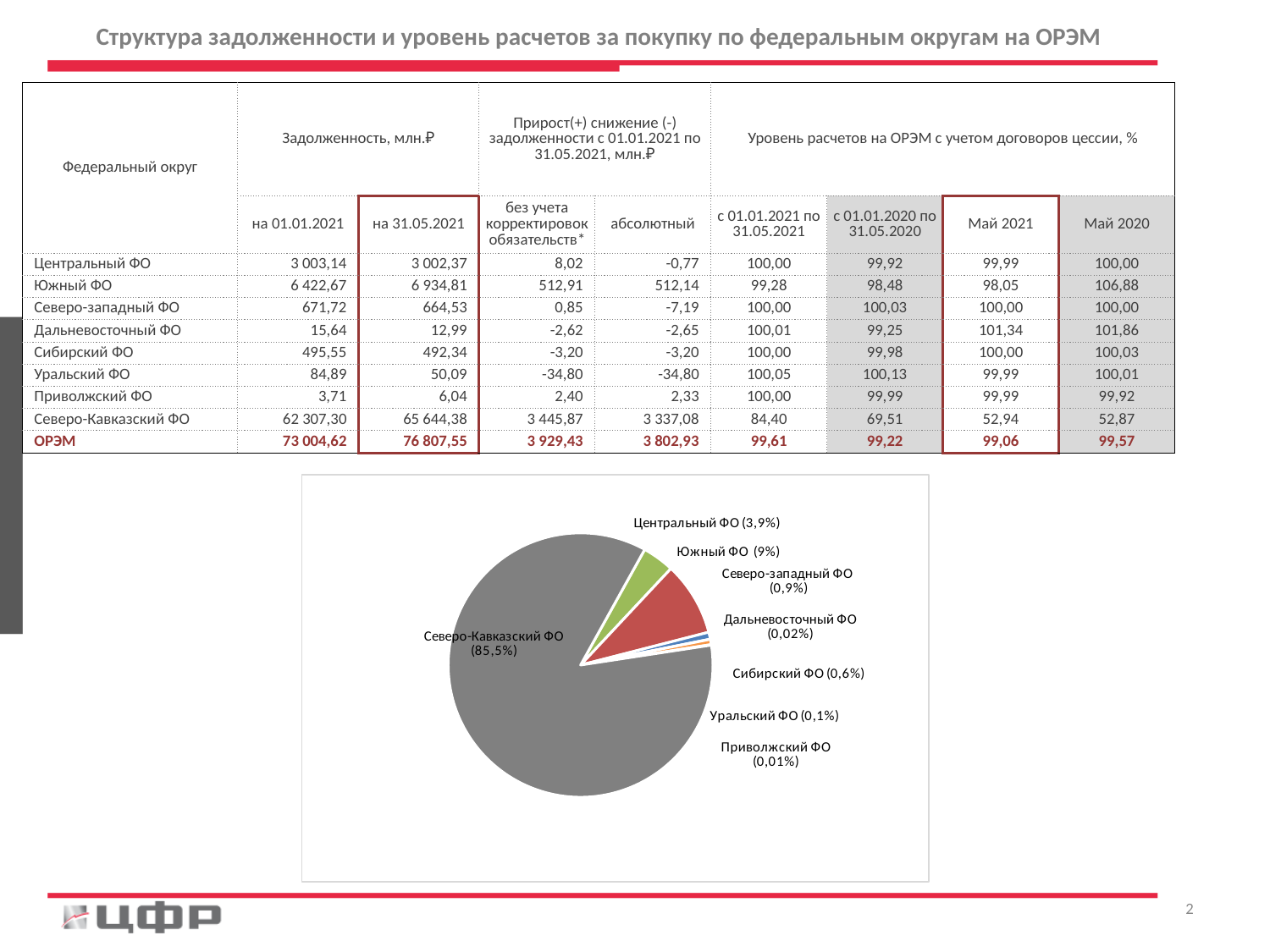
Which federal district has the largest share in the pie chart? Северо-Кавказский ФО What is the percentage shown for Северо-западный ФО in the pie chart? 0,9% What share of the pie does Южный ФО account for? 9% What colour is the slice for Северо-Кавказский ФО in the pie chart? grey What kind of chart is shown on the slide? pie chart Which federal district has the smallest share in the pie chart? Приволжский ФО What is the percentage shown for Центральный ФО in the pie chart? 3,9% What share of the pie does Северо-Кавказский ФО account for? 85,5% What is the difference in percentage points between the shares of Северо-Кавказский ФО and Южный ФО in the pie chart? 76,5 How many slices does the pie chart have? 8 Which has a larger share in the pie chart, Южный ФО or Центральный ФО? Южный ФО What is the percentage shown for Дальневосточный ФО in the pie chart? 0,02%